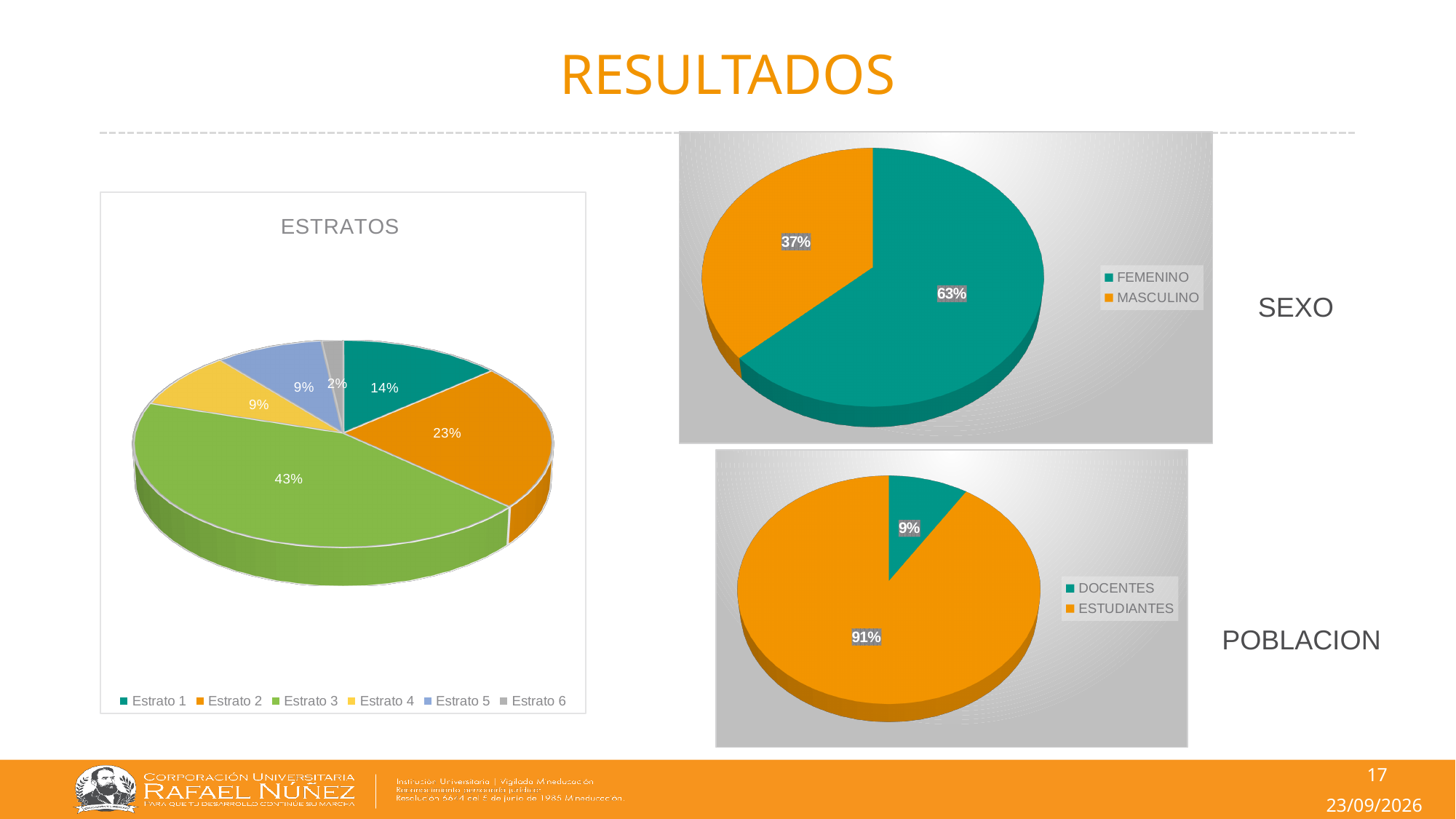
In the ESTRATOS chart, what is the value for Estrato 2? 23% In the ESTRATOS chart, which category has the largest slice? Estrato 3 In the SEXO chart, what share is FEMENINO? 63% In the POBLACION chart, what share is DOCENTES? 9% In the ESTRATOS chart, what share of the pie does Estrato 3 have? 43% In the ESTRATOS chart, which is larger, Estrato 1 or Estrato 2? Estrato 2 What type of chart is the POBLACION chart? Pie chart In the ESTRATOS chart, which category has the smallest slice? Estrato 6 In the ESTRATOS chart, what is the difference between Estrato 3 and Estrato 2? 20% In the SEXO chart, what is the difference between FEMENINO and MASCULINO? 26% In the POBLACION chart, which category is larger, DOCENTES or ESTUDIANTES? ESTUDIANTES In the ESTRATOS chart, how many categories does the legend list? 6